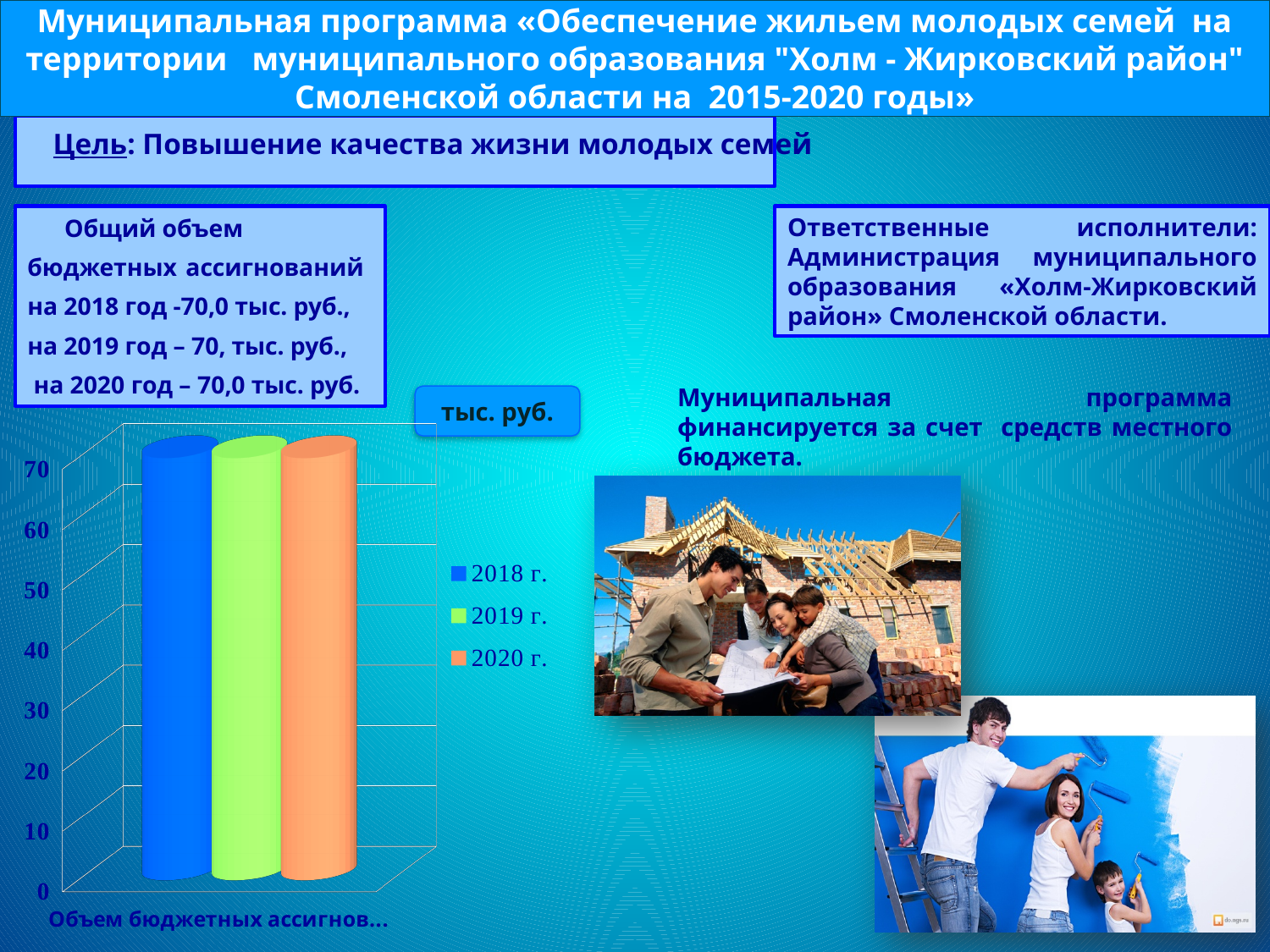
What is the highest value shown on the chart's vertical axis? 70 What is the value of the bar for 2019 г. in the chart? 70 Is the value for 2020 г. greater or less than 60? greater What is the value of the bar for 2018 г. in the chart? 70 Is the value for 2018 г. greater or less than 50? greater What kind of chart is shown on the slide? bar chart Do the values rise, fall or stay the same from 2018 г. to 2020 г.? stay the same How many bars are plotted in the chart? 3 How many series does the chart legend list? 3 What unit label is shown above the chart? тыс. руб. What is the value of the bar for 2020 г. in the chart? 70 Which years are listed in the chart legend? 2018 г., 2019 г., 2020 г.